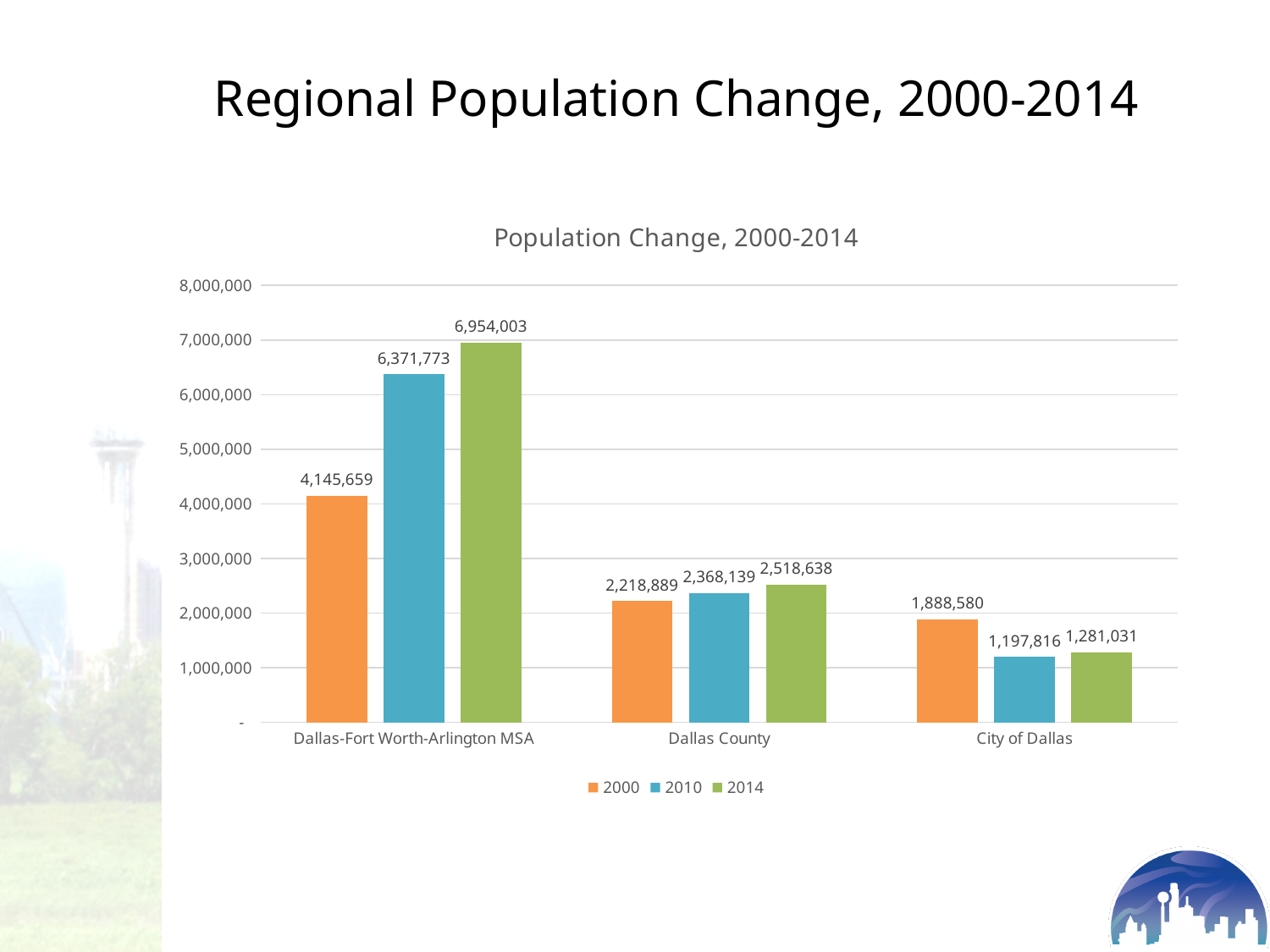
What is the 2000 population value for Dallas County? 2,218,889 For the City of Dallas, which is larger: the 2000 value or the 2014 value? 2000 How many series does the legend list? 3 Which region has the highest 2014 population value? Dallas-Fort Worth-Arlington MSA What is the 2014 population value for the Dallas-Fort Worth-Arlington MSA? 6,954,003 Is the 2010 value for the Dallas-Fort Worth-Arlington MSA greater or less than 6,000,000? greater What is the 2010 population value for the City of Dallas? 1,197,816 What is the difference between the 2014 and 2000 population values for Dallas County? 299,749 By how much did the Dallas-Fort Worth-Arlington MSA population increase from 2000 to 2014? 2,808,344 How many regions (categories) are shown on the x axis? 3 What type of chart is shown on the slide? Bar chart Which region has the lowest 2010 population value? City of Dallas